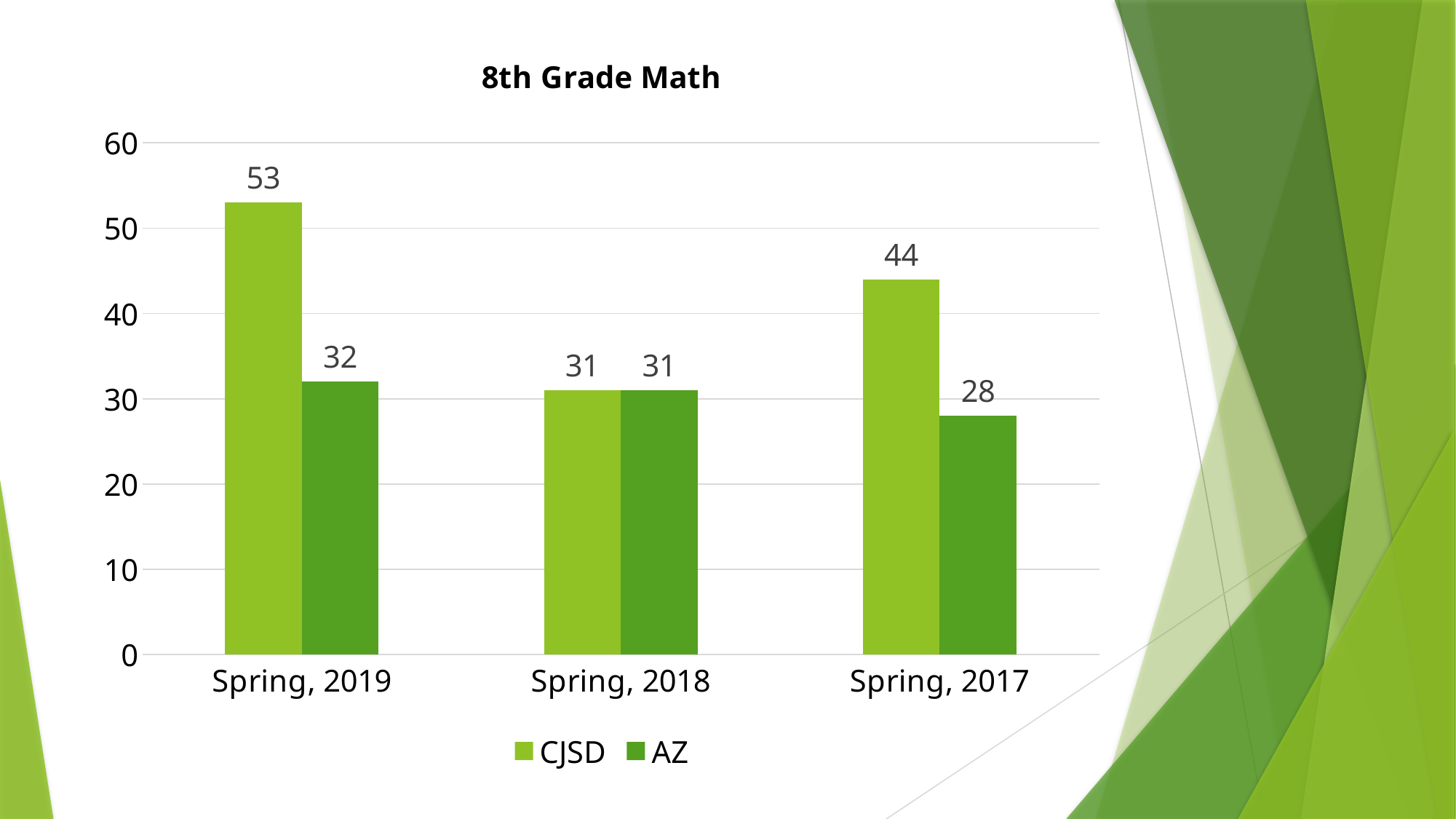
What is the title of the chart? 8th Grade Math Which is larger for Spring, 2017: the CJSD value or the AZ value? CJSD What is the difference between the CJSD values for Spring, 2019 and Spring, 2017? 9 What is the CJSD value for Spring, 2019? 53 Which category has the highest CJSD value? Spring, 2019 Which category has the lowest AZ value? Spring, 2017 What is the AZ value for Spring, 2017? 28 What is the difference between the CJSD and AZ values for Spring, 2019? 21 What is the AZ value for Spring, 2018? 31 How many categories are shown on the x axis? 3 What kind of chart is shown on the slide? Bar chart How many series does the legend list? 2